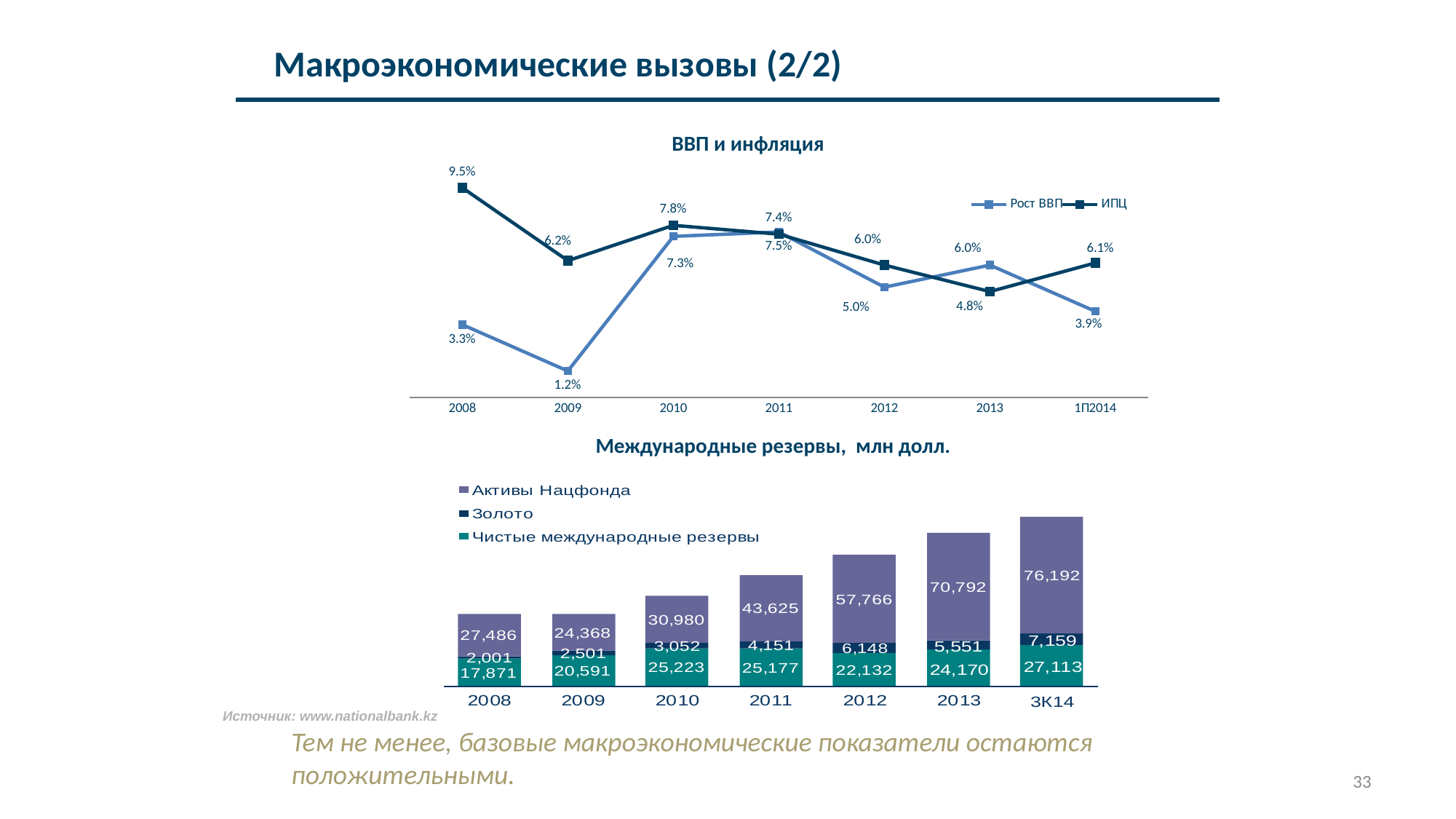
In the 'ВВП и инфляция' chart, what is the ИПЦ value for 2008? 9.5% In the 'Международные резервы, млн долл.' chart, what is the total of the stacked bar for 2008? 47,358 In the 'ВВП и инфляция' chart, which is larger in 2013: Рост ВВП or ИПЦ? Рост ВВП In the 'ВВП и инфляция' chart, what is the difference between ИПЦ and Рост ВВП in 2008? 6.2% In the 'ВВП и инфляция' chart, how many series does the legend list? 2 In the 'ВВП и инфляция' chart, what is the Рост ВВП value for 2009? 1.2% In the 'Международные резервы, млн долл.' chart, which period has the highest Активы Нацфонда value? 3К14 In the 'Международные резервы, млн долл.' chart, what is the difference between Активы Нацфонда in 2013 and 2012? 13,026 In the 'Международные резервы, млн долл.' chart, how many periods are shown on the x axis? 7 What kind of chart is 'Международные резервы, млн долл.'? Stacked bar chart In the 'Международные резервы, млн долл.' chart, what is the value of Золото for 2012? 6,148 In the 'ВВП и инфляция' chart, which year has the lowest Рост ВВП value? 2009